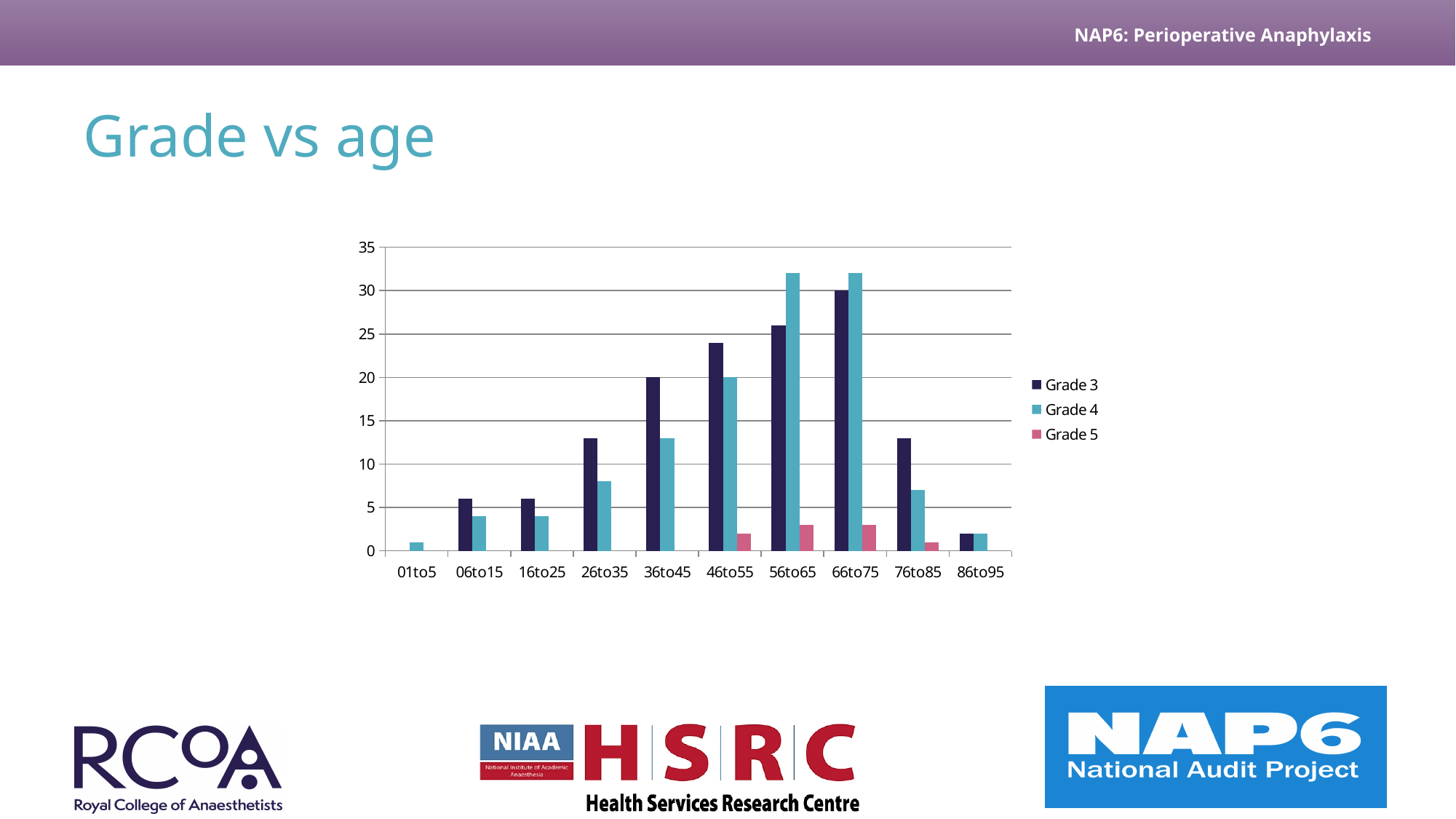
Is the Grade 4 value for 56to65 greater or less than 30? greater What type of chart is shown on the slide? bar chart In the 46to55 age group, which is larger, Grade 3 or Grade 4? Grade 3 Which age group has the highest Grade 3 value? 66to75 How many age categories are shown on the x axis? 10 What is the Grade 3 value for the 36to45 age group? 20 How many series does the legend list? 3 What is the difference between the Grade 3 values for 66to75 and 36to45? 10 What is the Grade 3 value for the 66to75 age group? 30 What is the Grade 4 value for the 46to55 age group? 20 In the 56to65 age group, which is larger, Grade 3 or Grade 4? Grade 4 Is the Grade 5 value for 56to65 greater or less than 5? less